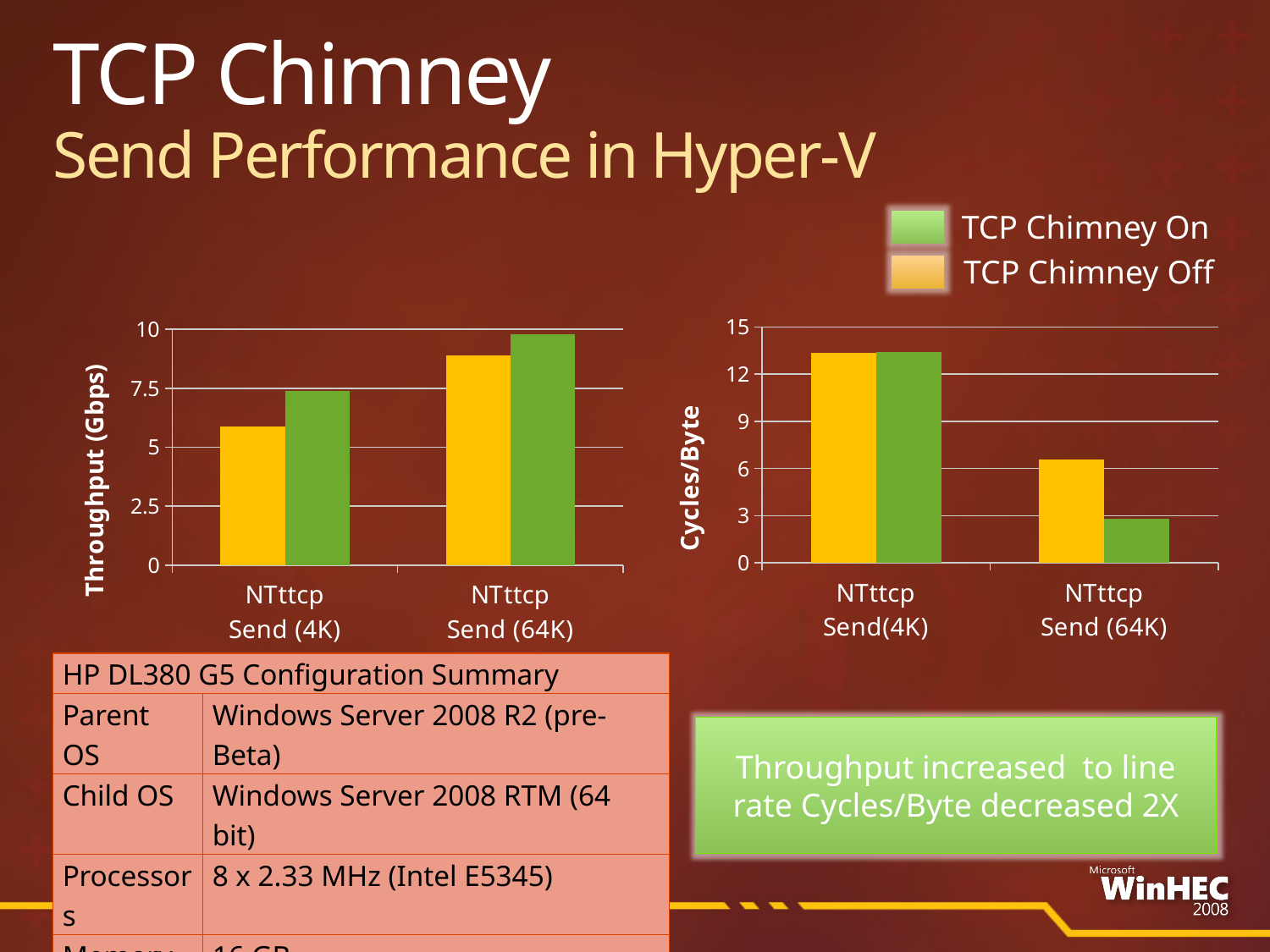
In the Cycles/Byte chart, how many series does the legend list? 2 In the Cycles/Byte chart, which is larger for NTttcp Send (64K): TCP Chimney On or TCP Chimney Off? TCP Chimney Off In the legend, which colour represents TCP Chimney Off? orange In the Throughput (Gbps) chart, is the TCP Chimney On value for NTttcp Send (64K) greater or less than 7.5? greater In the Throughput (Gbps) chart, how many categories are shown on the x axis? 2 In the Throughput (Gbps) chart, what kind of chart is shown? bar chart In the Cycles/Byte chart, is the TCP Chimney Off value for NTttcp Send (64K) greater or less than 6? greater In the Throughput (Gbps) chart, do the TCP Chimney Off values rise or fall from NTttcp Send (4K) to NTttcp Send (64K)? rise In the Cycles/Byte chart, do the TCP Chimney On values rise or fall from NTttcp Send(4K) to NTttcp Send (64K)? fall In the Throughput (Gbps) chart, which is larger for NTttcp Send (4K): TCP Chimney On or TCP Chimney Off? TCP Chimney On In the Throughput (Gbps) chart, is the TCP Chimney Off value for NTttcp Send (4K) greater or less than 7.5? less